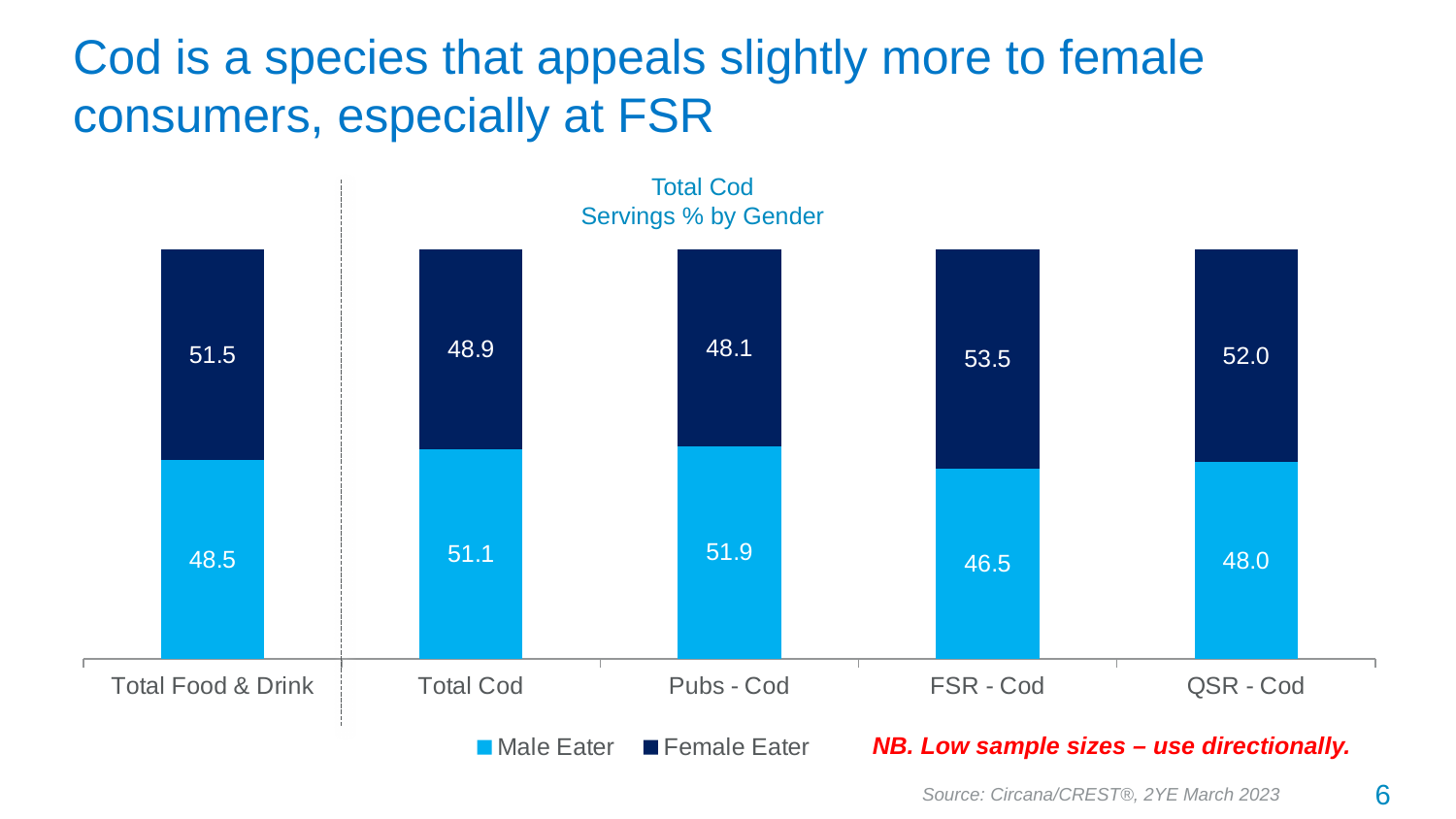
Which category has the highest Female Eater value? FSR - Cod Which category has the lowest Male Eater value? FSR - Cod What is the title of the chart? Total Cod Servings % by Gender What is the Female Eater value for QSR - Cod? 52.0 How many categories are shown on the x axis? 5 Is the Male Eater value larger for Total Cod or for QSR - Cod? Total Cod What is the Male Eater value for FSR - Cod? 46.5 What kind of chart is shown? Stacked bar chart What is the difference between the Female Eater and Male Eater values for FSR - Cod? 7.0 What is the Female Eater value for Total Food & Drink? 51.5 What is the Male Eater value for Pubs - Cod? 51.9 How many series does the legend list? 2